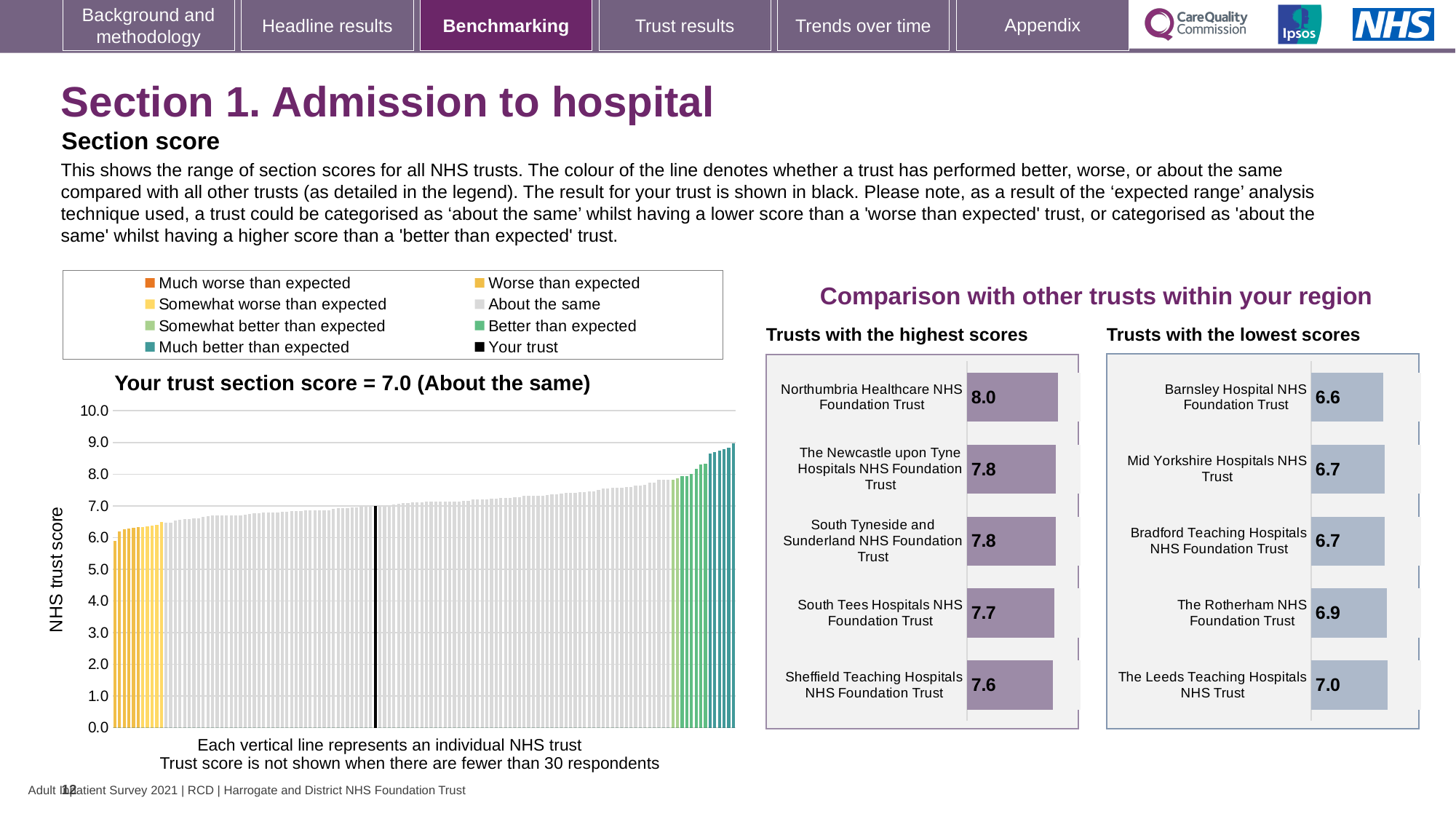
How many entries does the legend above the main chart on the left list? 8 In the 'Trusts with the lowest scores' chart, which trust has the lowest score? Barnsley Hospital NHS Foundation Trust How many trusts are shown in the 'Trusts with the highest scores' chart? 5 According to the title of the main chart on the left, what is your trust's section score? 7.0 In the 'Trusts with the highest scores' chart, what is the score for South Tees Hospitals NHS Foundation Trust? 7.7 In the 'Trusts with the lowest scores' chart, what is the score for Barnsley Hospital NHS Foundation Trust? 6.6 In the 'Trusts with the highest scores' chart, what is the score for Northumbria Healthcare NHS Foundation Trust? 8.0 In the 'Trusts with the highest scores' chart, what is the difference between the scores of Northumbria Healthcare NHS Foundation Trust and Sheffield Teaching Hospitals NHS Foundation Trust? 0.4 In the 'Trusts with the lowest scores' chart, which has the larger score: The Rotherham NHS Foundation Trust or The Leeds Teaching Hospitals NHS Trust? The Leeds Teaching Hospitals NHS Trust What kind of chart is the main chart on the left showing NHS trust scores? Bar chart In the main chart on the left, do the trust scores rise or fall from left to right? Rise In the 'Trusts with the highest scores' chart, which trust has the highest score? Northumbria Healthcare NHS Foundation Trust